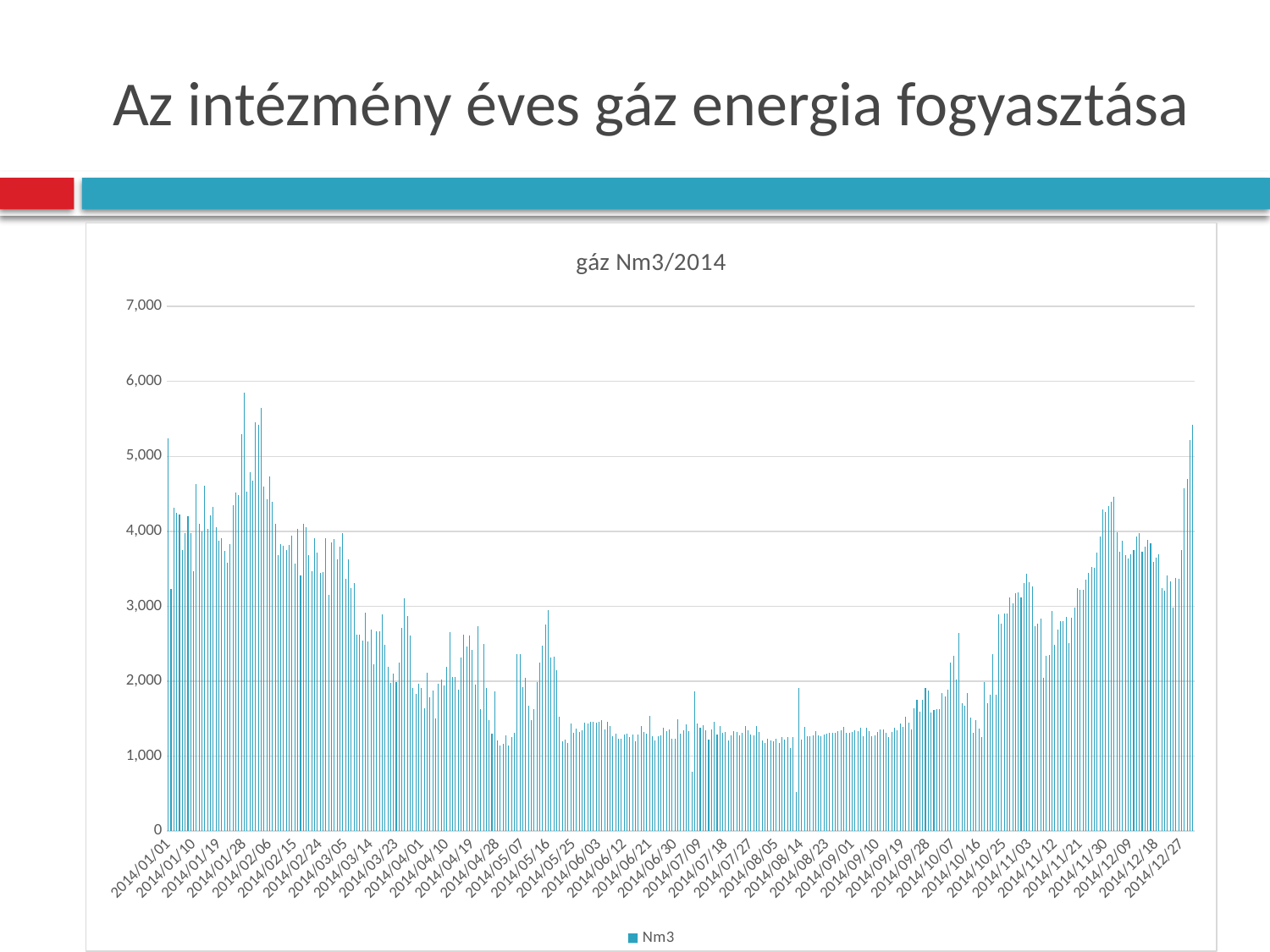
Is the value for 2014/01/01 greater or less than 4,000? greater What is the name of the series shown in the legend? Nm3 What kind of chart is shown on the slide? bar chart Do the values generally rise or fall from 2014/09/28 to 2014/12/27? rise What is the title of the chart? gáz Nm3/2014 Is the highest value in the chart greater or less than 6,000? less Is the highest value in the chart greater or less than 5,000? greater Do the values generally rise or fall from 2014/01/01 to 2014/05/07? fall How many series does the legend list? 1 Which is larger, the value for 2014/01/01 or the value for 2014/07/09? 2014/01/01